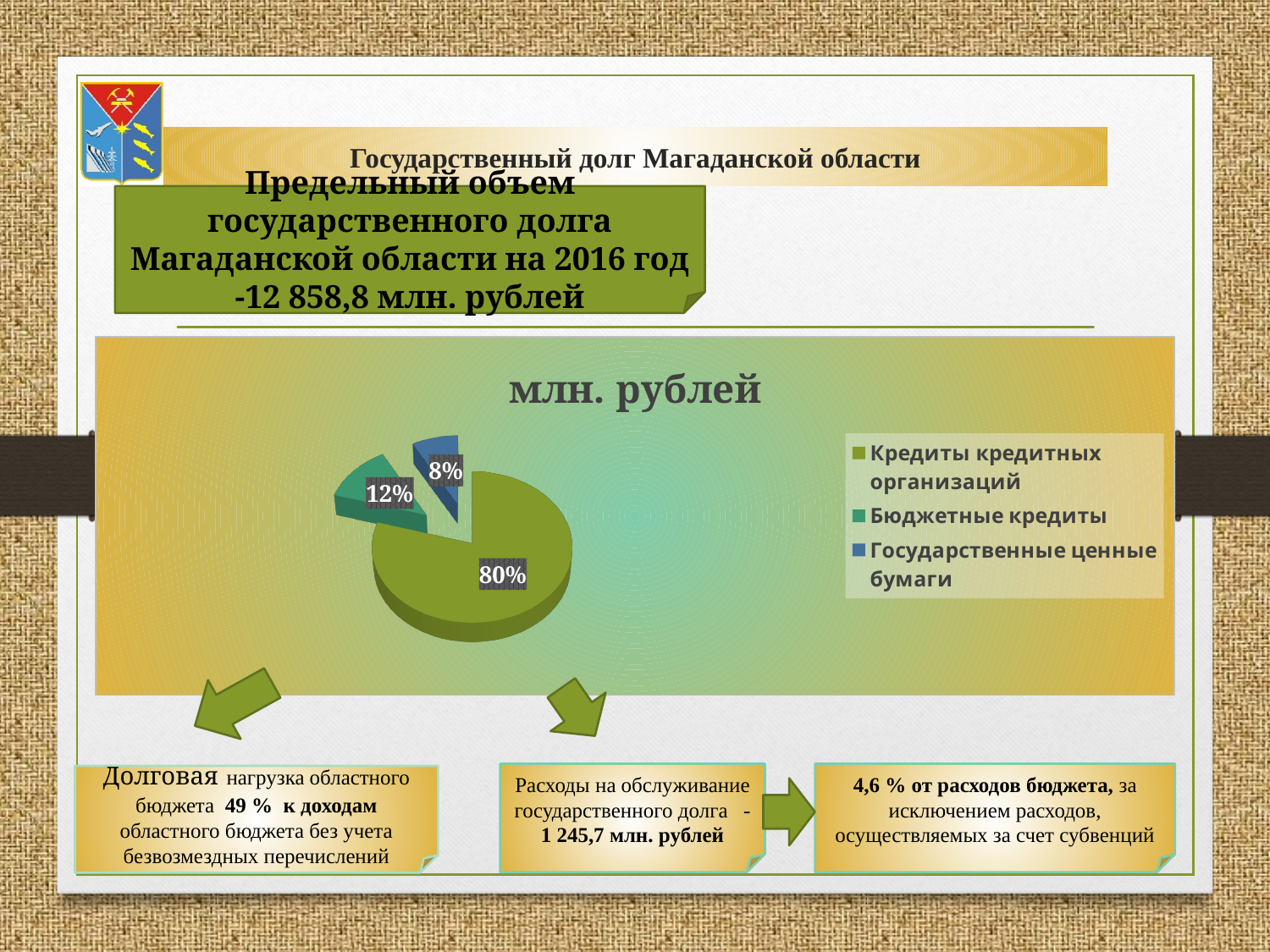
What share of the pie is labelled for Государственные ценные бумаги? 8% Which category has the largest slice of the pie? Кредиты кредитных организаций What share of the pie is labelled for Кредиты кредитных организаций? 80% What is the title of the chart? млн. рублей Which category has the smallest slice of the pie? Государственные ценные бумаги What kind of chart is shown on the slide? Pie chart What is the difference in percentage points between the Кредиты кредитных организаций slice and the Бюджетные кредиты slice? 68 How many entries does the chart legend list? 3 What share of the pie is labelled for Бюджетные кредиты? 12% Which slice is larger: Бюджетные кредиты or Государственные ценные бумаги? Бюджетные кредиты How many slices does the pie chart have? 3 Which legend entry is shown in blue? Государственные ценные бумаги